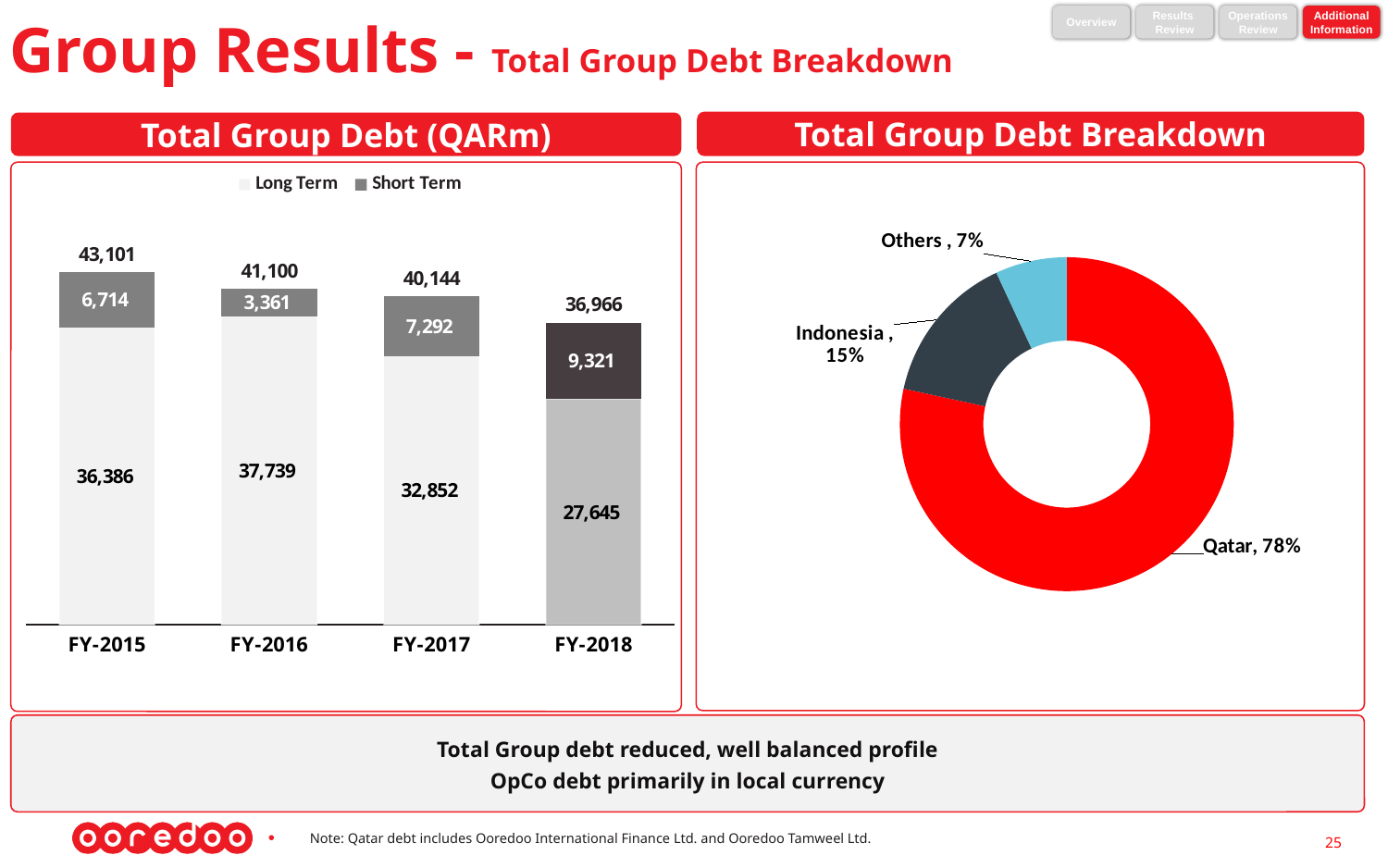
In the Total Group Debt (QARm) chart, what is the Short Term debt value for FY-2018? 9,321 In the Total Group Debt (QARm) chart, is the Short Term debt larger in FY-2016 or FY-2017? FY-2017 What kind of chart is the Total Group Debt Breakdown chart? Pie (donut) chart In the Total Group Debt (QARm) chart, what is the Long Term debt value for FY-2016? 37,739 In the Total Group Debt (QARm) chart, how many series does the legend list? 2 In the Total Group Debt Breakdown chart, what share of debt is attributed to Indonesia? 15% In the Total Group Debt Breakdown chart, how many slices are shown? 3 In the Total Group Debt (QARm) chart, what is the total debt shown for FY-2017? 40,144 In the Total Group Debt (QARm) chart, which fiscal year has the highest total debt? FY-2015 In the Total Group Debt (QARm) chart, does the total debt rise or fall from FY-2015 to FY-2018? Fall In the Total Group Debt (QARm) chart, which fiscal year has the lowest Long Term debt? FY-2018 In the Total Group Debt (QARm) chart, what is the difference between the total debt in FY-2015 and FY-2018? 6,135